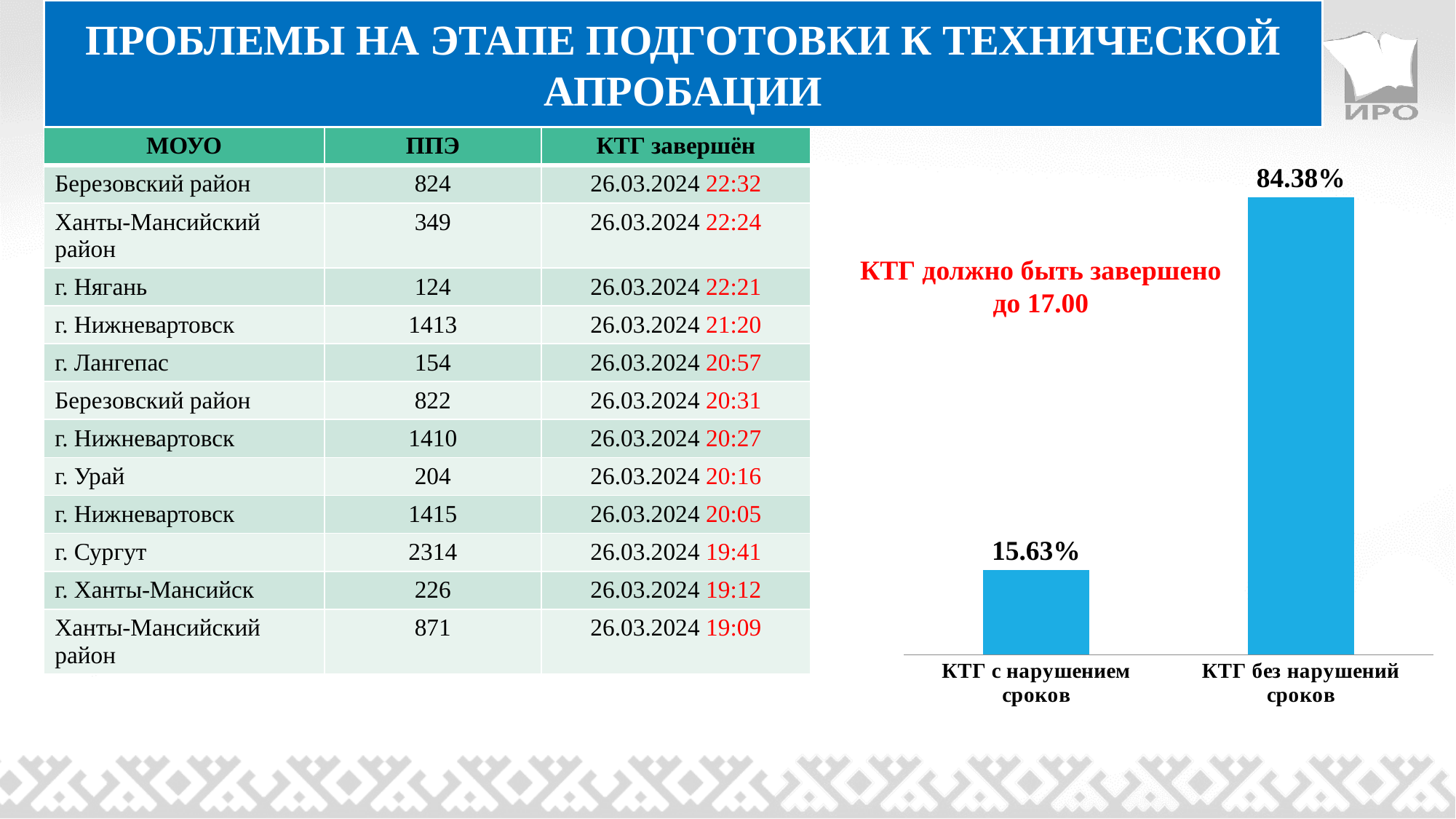
Which category has the highest value in the chart? КТГ без нарушений сроков Which is larger: the value for КТГ с нарушением сроков or the value for КТГ без нарушений сроков? КТГ без нарушений сроков What kind of chart is shown on the right side of the slide? bar chart What is the value for КТГ без нарушений сроков? 84.38% How many categories are shown in the bar chart? 2 Do the values rise or fall from left to right along the x axis? rise What is the label of the left bar in the chart? КТГ с нарушением сроков What colour are the bars in the chart? blue What is the difference between the values for КТГ без нарушений сроков and КТГ с нарушением сроков? 68.75% What is the value for КТГ с нарушением сроков? 15.63% Which category has the lowest value in the chart? КТГ с нарушением сроков